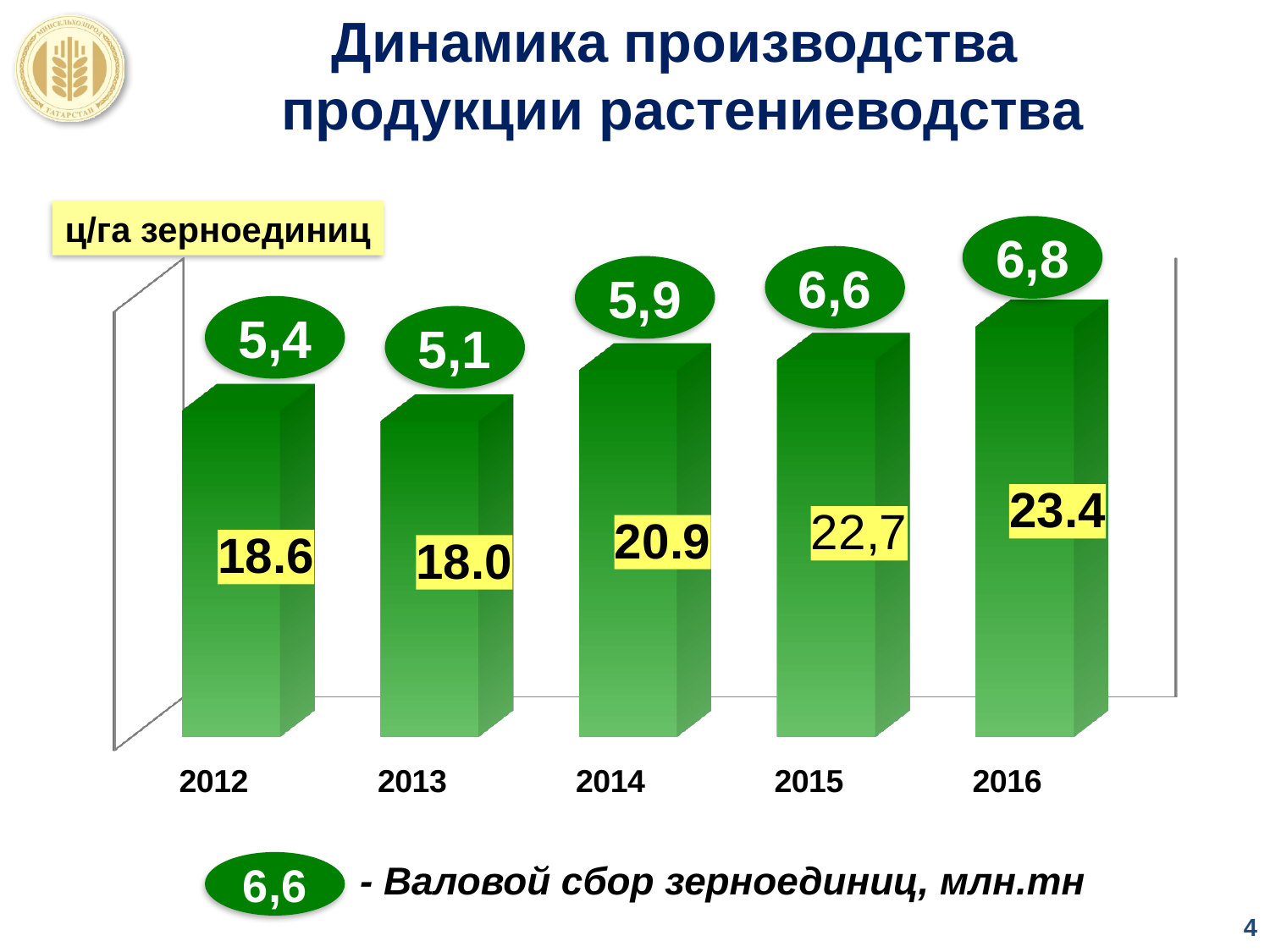
What gross harvest value (валовой сбор зерноединиц, млн.тн) is shown in the green oval above the 2013 bar? 5,1 Which year has the highest yield value (ц/га зерноединиц)? 2016 What gross harvest value (валовой сбор зерноединиц, млн.тн) is shown in the green oval above the 2014 bar? 5,9 What is the yield value (ц/га зерноединиц) shown on the bar for 2012? 18.6 What kind of chart is shown on the slide? bar chart Which year has the larger yield value, 2014 or 2015? 2015 How many years are shown on the chart? 5 What is the difference between the gross harvest values (млн.тн) for 2016 and 2013? 1,7 What is the yield value (ц/га зерноединиц) shown on the bar for 2015? 22,7 What is the title of the slide? Динамика производства продукции растениеводства What is the difference between the yield values for 2016 and 2012? 4.8 Which year has the lowest yield value (ц/га зерноединиц)? 2013